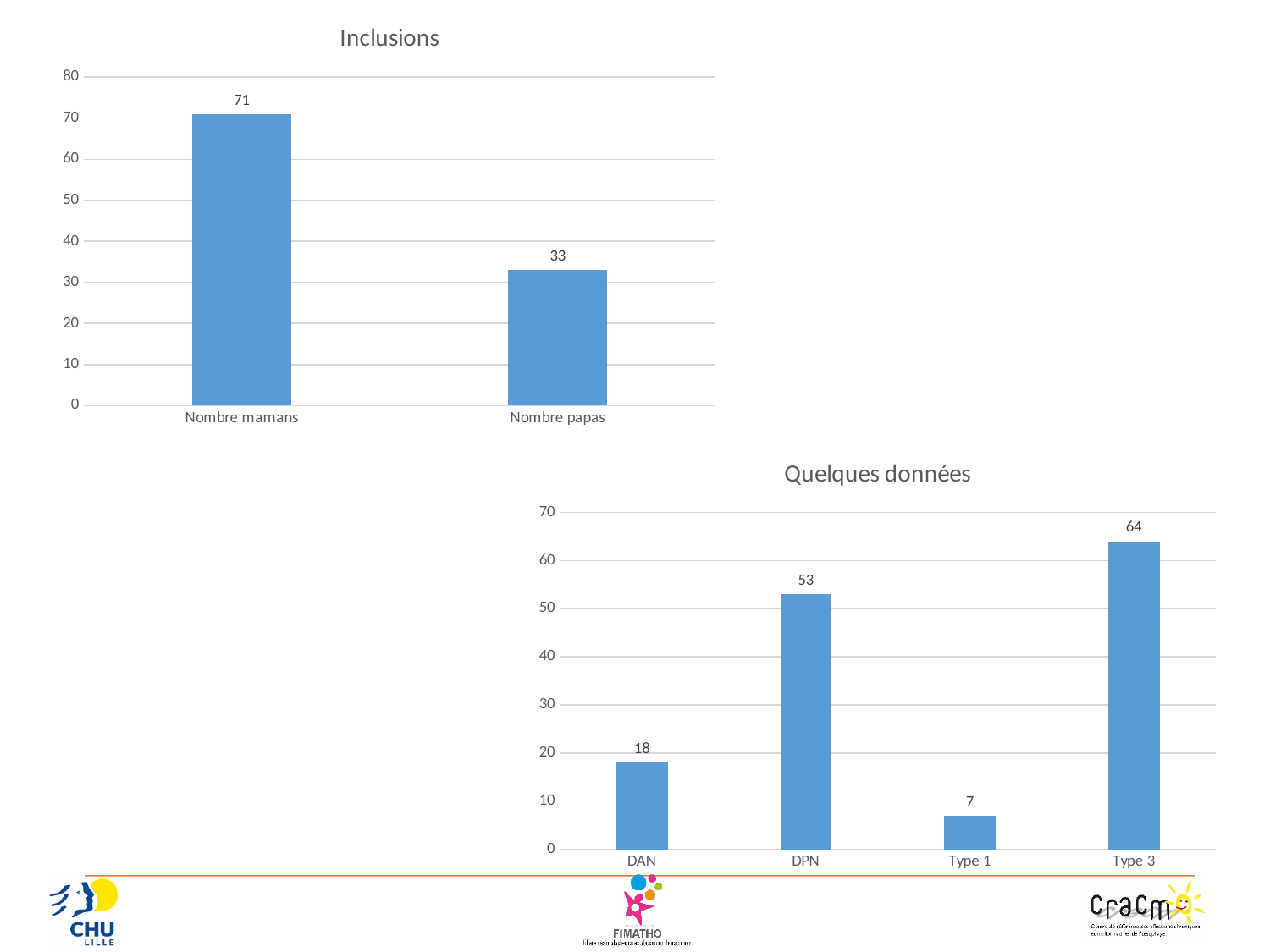
In the 'Inclusions' chart, what is the value for Nombre papas? 33 In the 'Inclusions' chart, what is the difference between Nombre mamans and Nombre papas? 38 In the 'Quelques données' chart, which is larger, DAN or DPN? DPN In the 'Inclusions' chart, how many categories are shown? 2 In the 'Quelques données' chart, what is the difference between Type 3 and DAN? 46 In the 'Quelques données' chart, which category has the highest value? Type 3 In the 'Quelques données' chart, what is the value for Type 1? 7 In the 'Quelques données' chart, what is the value for DPN? 53 In the 'Inclusions' chart, what is the value for Nombre mamans? 71 In the 'Quelques données' chart, how many categories are shown? 4 What kind of chart is the 'Inclusions' chart? Bar chart In the 'Quelques données' chart, which category has the lowest value? Type 1